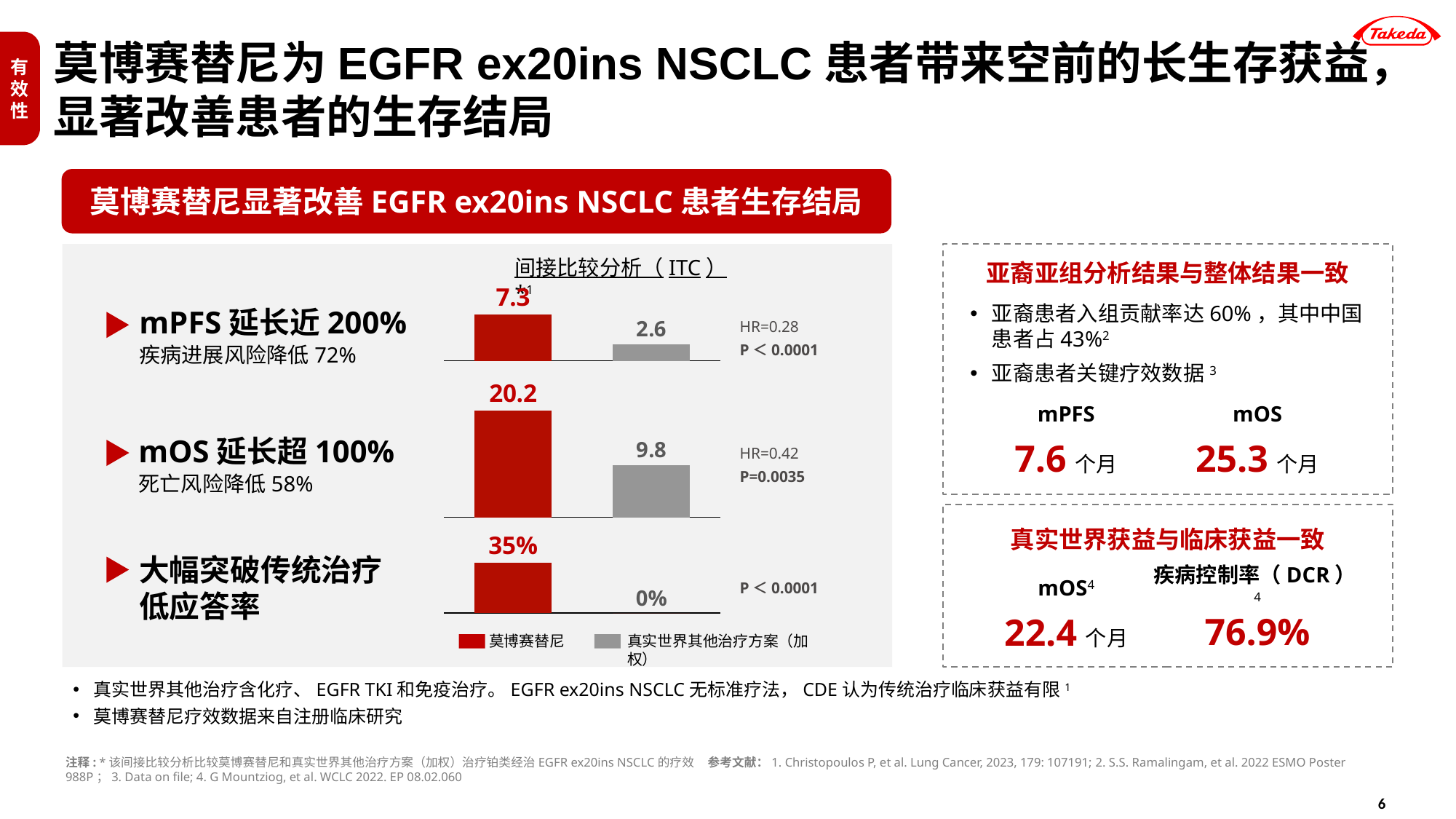
In the mPFS chart, what is the value for 莫博赛替尼? 7.3 In the mPFS chart, what is the value for 真实世界其他治疗方案（加权）? 2.6 How many series does the legend of the bar charts list? 2 In the mOS chart, what is the value for 真实世界其他治疗方案（加权）? 9.8 In the mPFS chart, what is the difference between the 莫博赛替尼 value and the 真实世界其他治疗方案（加权） value? 4.7 In the mOS chart, what is the value for 莫博赛替尼? 20.2 What kind of chart is used to compare 莫博赛替尼 with 真实世界其他治疗方案（加权）? Bar chart In the bar charts, which colour represents 莫博赛替尼? Red In the mOS chart, which series has the larger value, 莫博赛替尼 or 真实世界其他治疗方案（加权）? 莫博赛替尼 In the mOS chart, what is the difference between the 莫博赛替尼 value and the 真实世界其他治疗方案（加权） value? 10.4 In the response rate chart (大幅突破传统治疗低应答率), what is the value for 莫博赛替尼? 35% In the response rate chart (大幅突破传统治疗低应答率), what is the value for 真实世界其他治疗方案（加权）? 0%